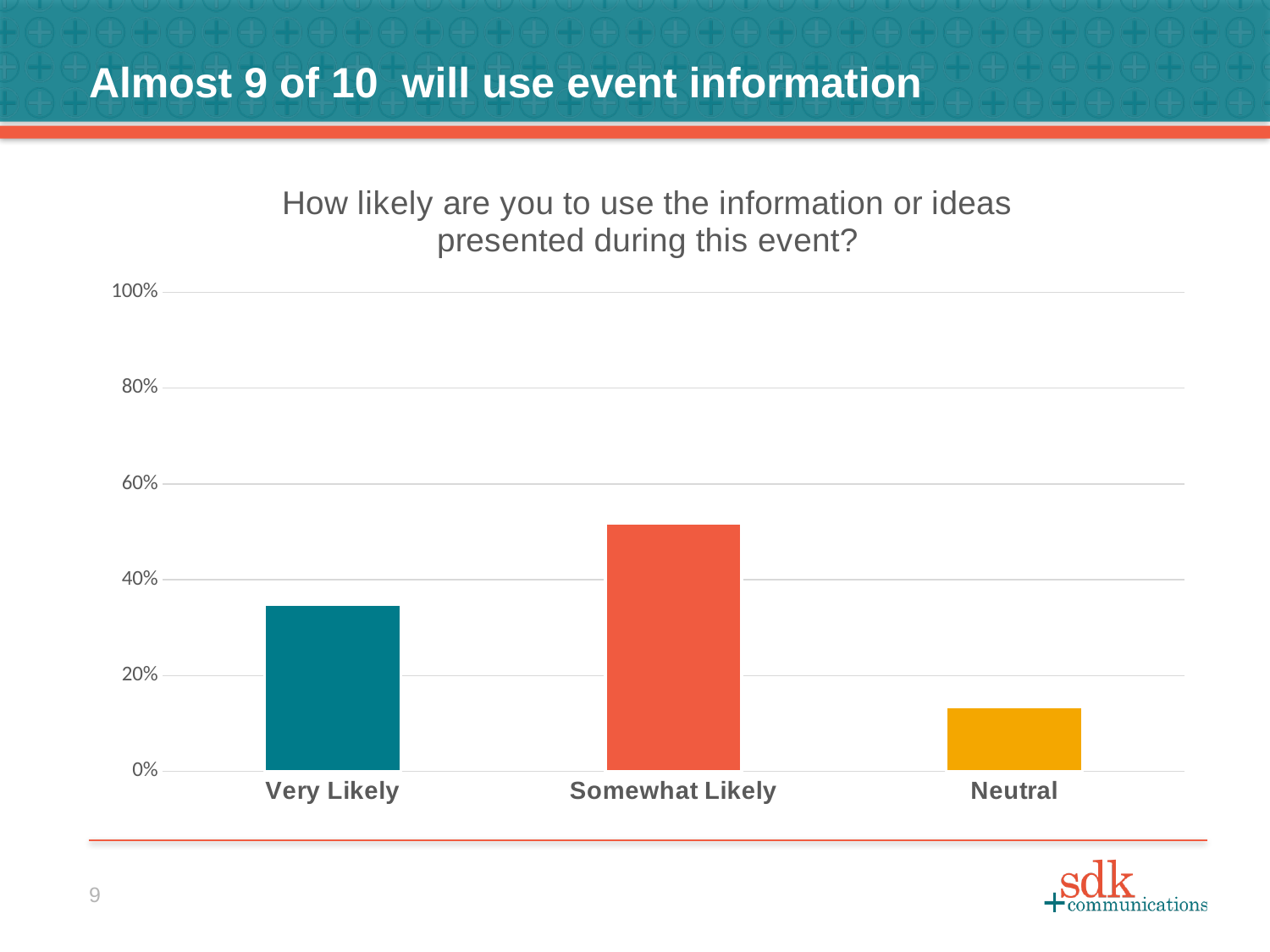
Which category has the lowest bar? Neutral Is the value for Somewhat Likely greater or less than 40%? greater Which is larger, the value for Very Likely or the value for Neutral? Very Likely Which is larger, the value for Somewhat Likely or the value for Very Likely? Somewhat Likely Is the value for Very Likely greater or less than 40%? less Is the value for Very Likely greater or less than 20%? greater How many categories are shown on the x axis of the chart? 3 What kind of chart is shown on the slide? bar chart What question is shown as the title of the chart? How likely are you to use the information or ideas presented during this event? Which category has the highest bar? Somewhat Likely